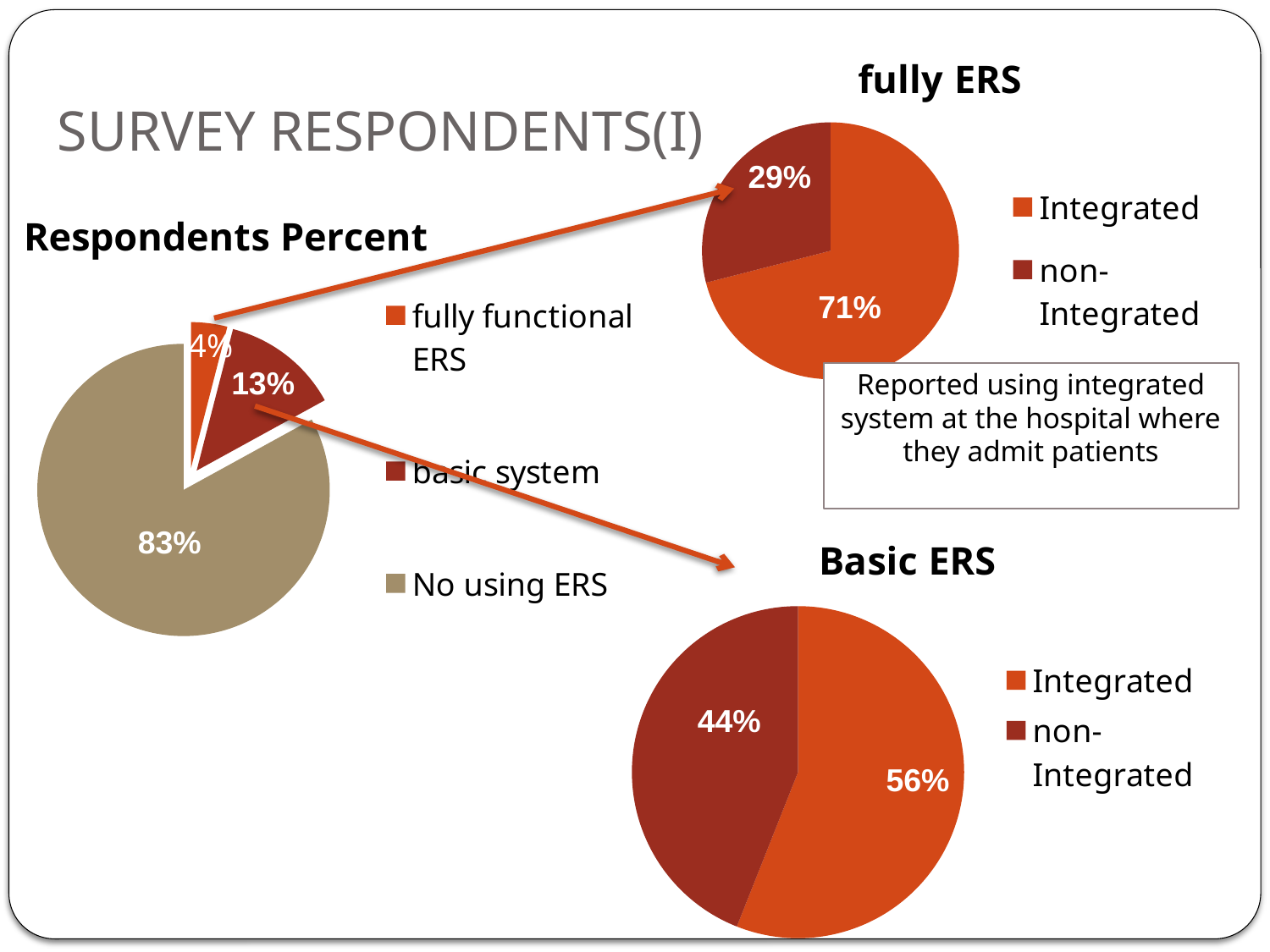
In the 'Basic ERS' chart, which is larger, Integrated or non-Integrated? Integrated In the 'fully ERS' chart, what percentage is Integrated? 71% In the 'Respondents Percent' chart, which category has the largest share? No using ERS In the 'Respondents Percent' chart, how many categories does the legend list? 3 In the 'Respondents Percent' chart, what percentage of respondents are not using ERS? 83% In the 'Respondents Percent' chart, what percentage of respondents have a basic system? 13% In the 'Basic ERS' chart, what is the difference between the Integrated and non-Integrated shares? 12% In the 'Basic ERS' chart, what percentage is Integrated? 56% In the 'fully ERS' chart, what percentage is non-Integrated? 29% In the 'Respondents Percent' chart, which category has the smallest share? fully functional ERS In the 'Respondents Percent' chart, what percentage of respondents have a fully functional ERS? 4% What type of chart is the 'fully ERS' chart? Pie chart